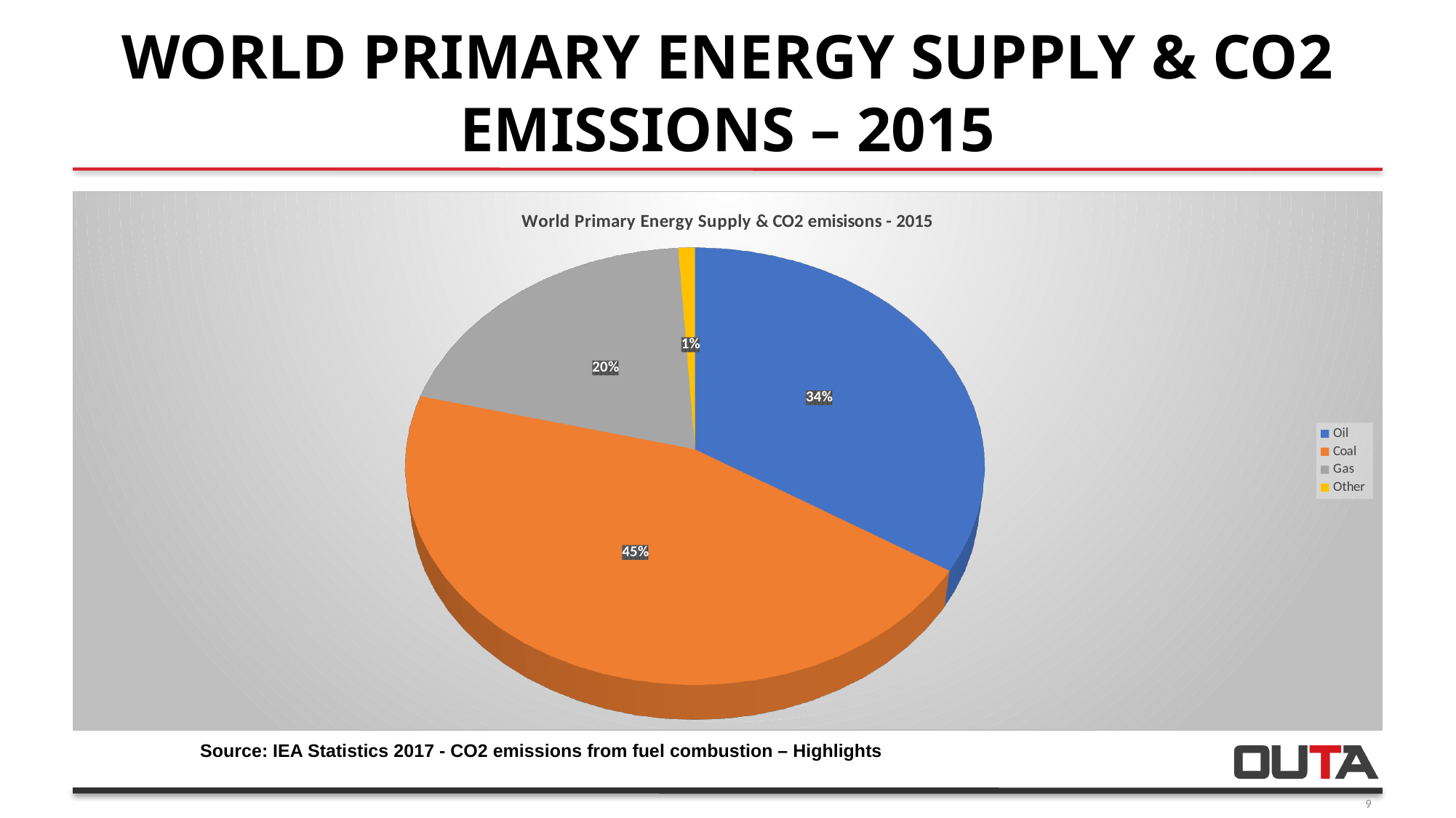
What is the difference in percentage points between the Coal and Oil slices? 11 What colour is the Gas slice in the pie chart? Grey What share of the pie does Oil account for? 34% Which is larger, the Oil slice or the Gas slice? Oil How many categories does the legend list? 4 What share of the pie does Gas account for? 20% What kind of chart is shown on the slide? Pie chart What share of the pie does Coal account for? 45% Which category has the smallest slice of the pie? Other Which category has the largest slice of the pie? Coal What is the title of the chart? World Primary Energy Supply & CO2 emisisons - 2015